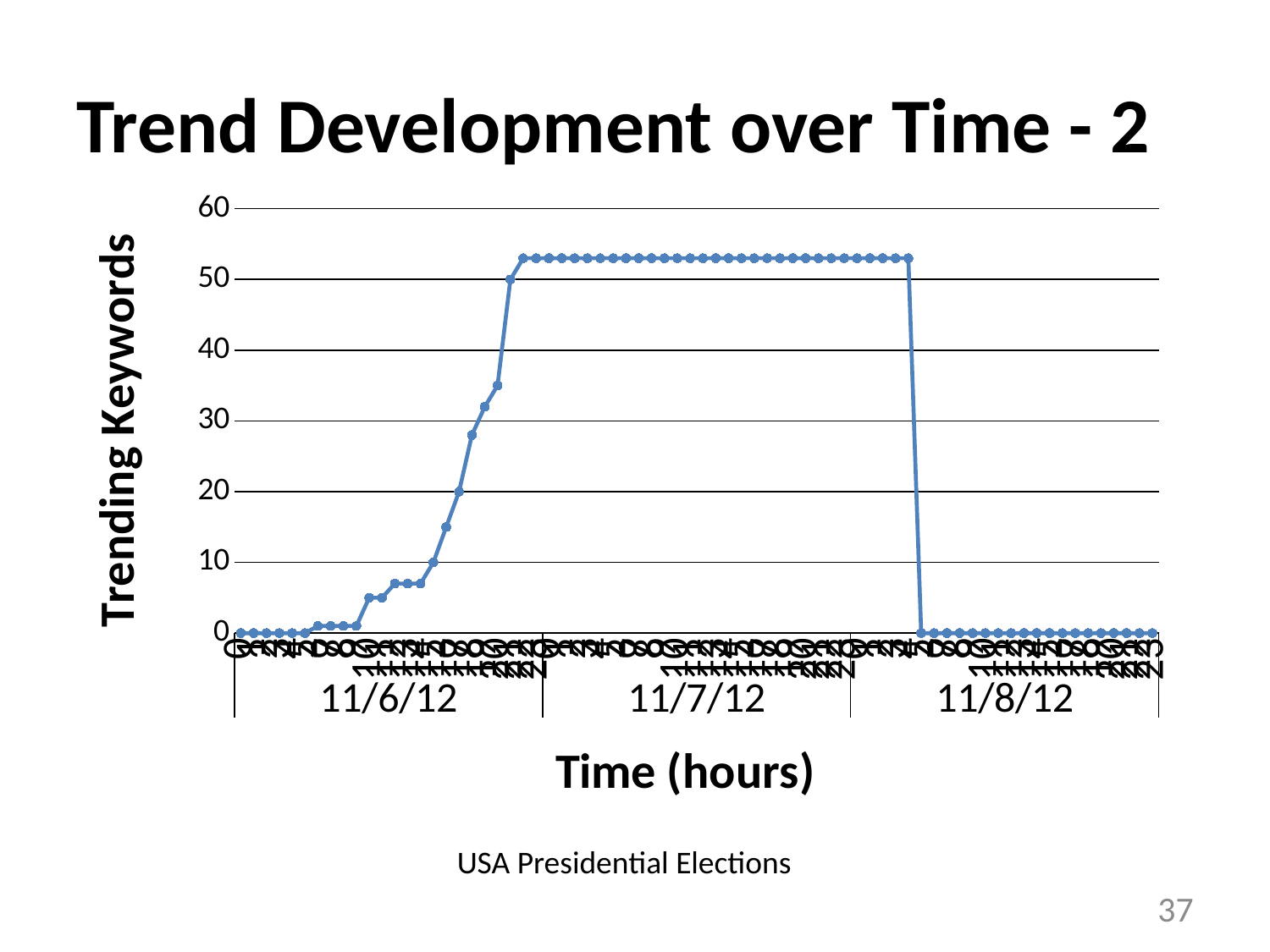
How many dates are labelled along the x axis? 3 Are the values at the start of 11/6/12 greater or less than 10? less Which date has higher values, 11/7/12 or 11/8/12? 11/7/12 What is the label of the vertical axis? Trending Keywords Is the value of the plateau reached during 11/7/12 greater or less than 50? greater What is the highest value shown on the vertical axis? 60 What is the title of the chart on the slide? Trend Development over Time - 2 What kind of chart is shown on the slide? line chart Is the value of the plateau reached during 11/7/12 greater or less than 60? less Do the values rise or fall over the course of 11/6/12? rise